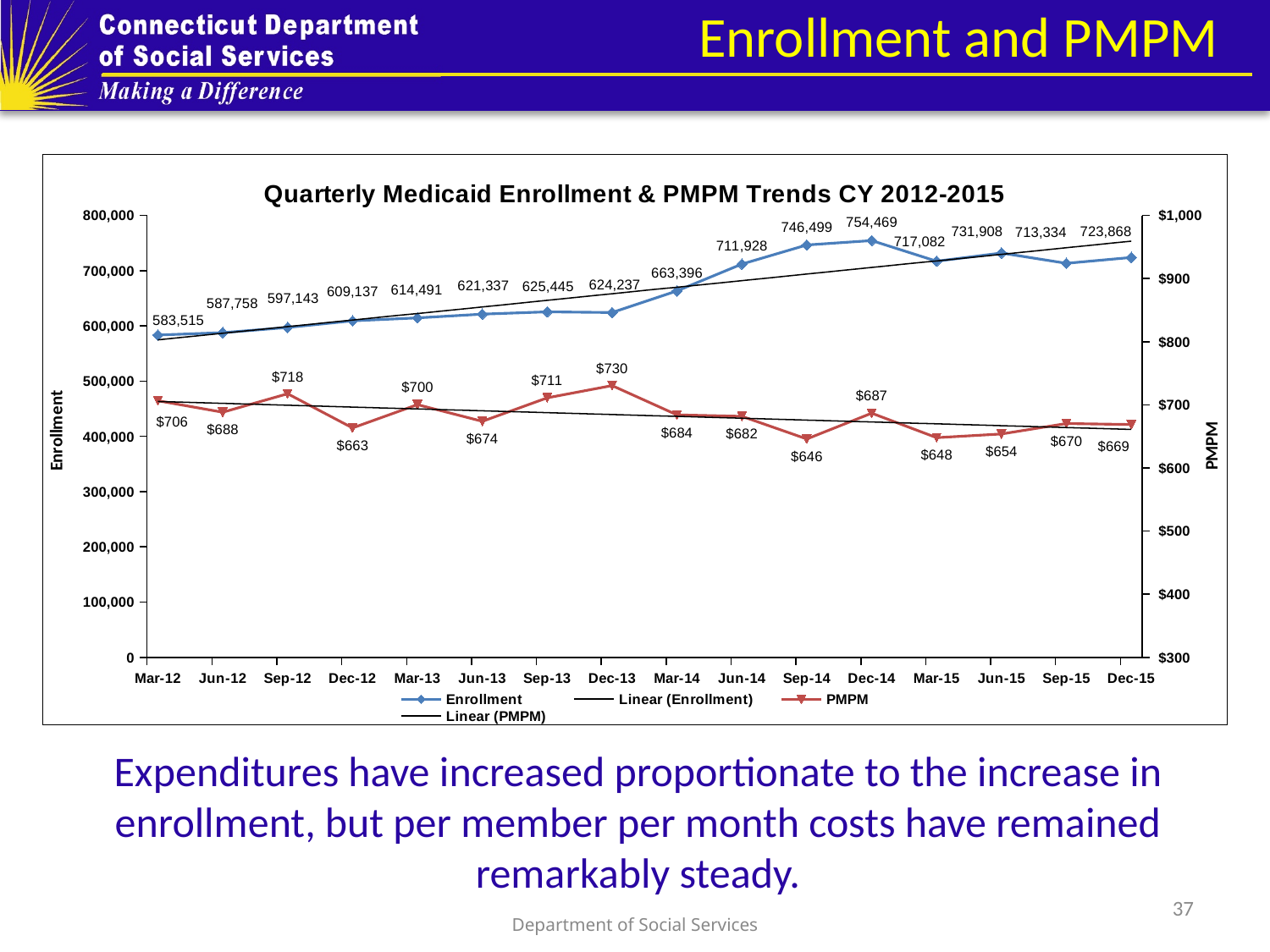
In which quarter is PMPM lowest? Sep-14 What is the difference between the highest PMPM (Dec-13) and the lowest PMPM (Sep-14)? $84 How many quarters are plotted on the x axis? 16 What is the PMPM value for Sep-12? $718 What is the Enrollment value for Dec-14? 754,469 How many entries does the legend list? 4 Which is larger, the Enrollment for Jun-15 or for Sep-15? Jun-15 In which quarter is PMPM highest? Dec-13 What is the difference in Enrollment between Dec-14 and Mar-12? 170,954 What kind of chart is shown on the slide? Line chart What is the Enrollment value for Mar-14? 663,396 In which quarter is Enrollment highest? Dec-14